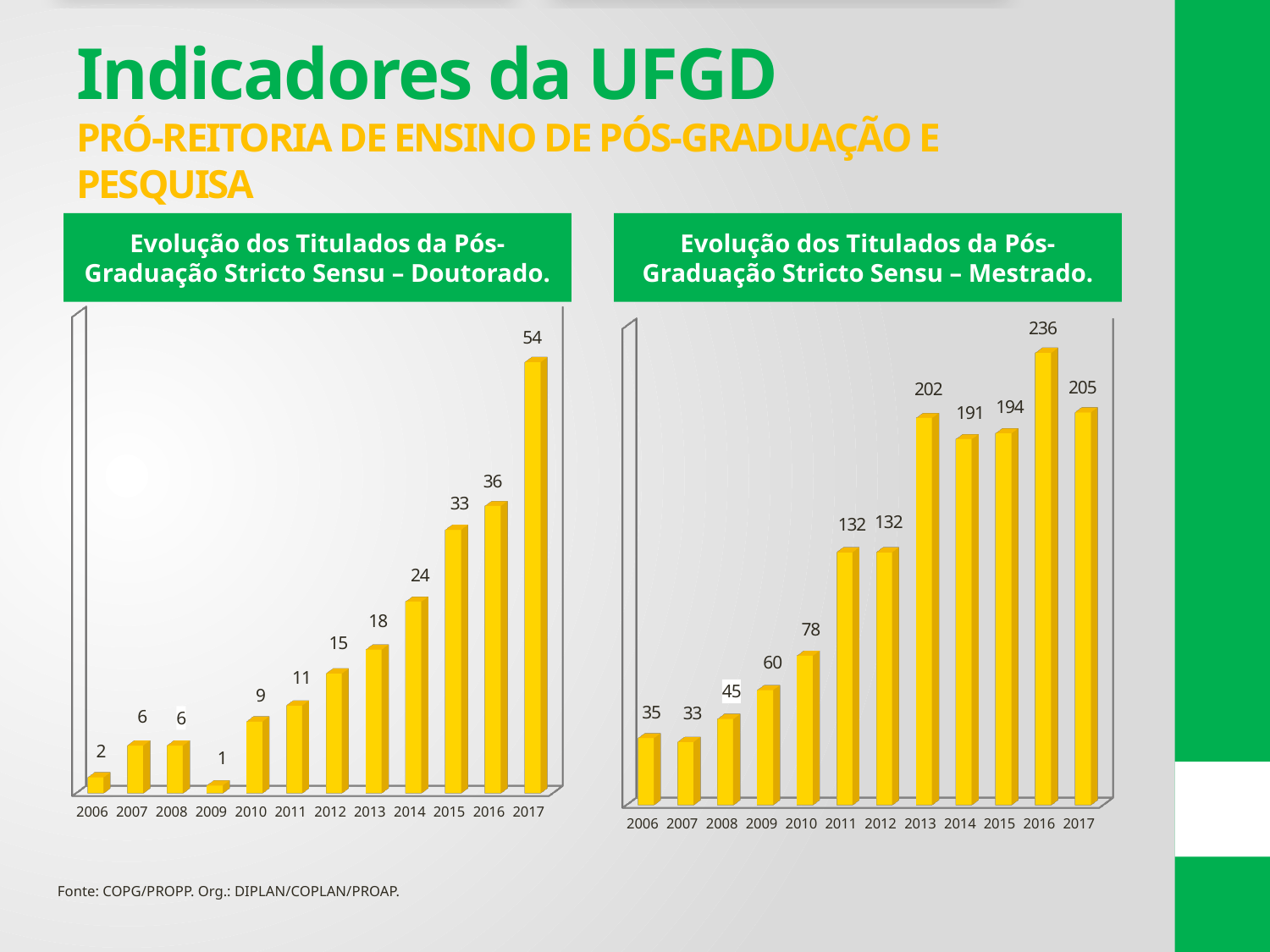
What kind of chart is the Mestrado chart (right)? Bar chart In the Mestrado chart (right), what is the value for 2016? 236 In the Mestrado chart (right), what is the difference between the values for 2016 and 2017? 31 How many years are shown on the x axis of the Doutorado chart (left)? 12 In the Doutorado chart (left), do the values generally rise or fall from 2009 to 2017? Rise In the Mestrado chart (right), which year has the lowest value? 2007 In the Doutorado chart (left), what is the value for 2017? 54 In the Doutorado chart (left), what is the difference between the values for 2017 and 2016? 18 In the Mestrado chart (right), what is the value for 2011? 132 In the Mestrado chart (right), which is larger, the value for 2013 or the value for 2014? 2013 In the Doutorado chart (left), which year has the lowest value? 2009 In the Mestrado chart (right), which year has the highest value? 2016